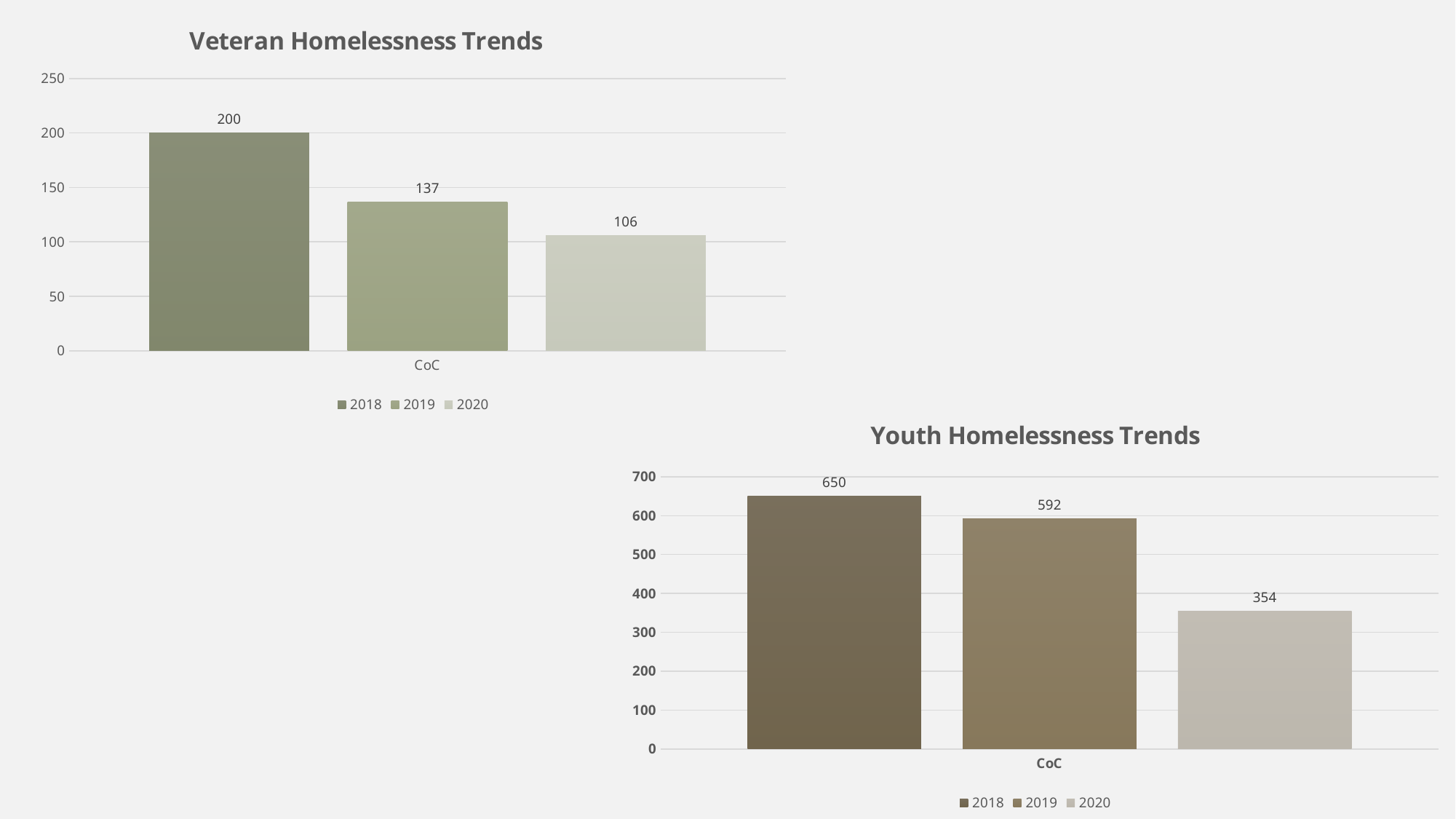
In the Veteran Homelessness Trends chart, do the values rise or fall from 2018 to 2020? Fall In the Youth Homelessness Trends chart, which is larger, the value for 2018 or the value for 2019? 2018 In the Youth Homelessness Trends chart, what is the value for 2019? 592 In the Youth Homelessness Trends chart, what is the difference between the 2019 and 2020 values? 238 In the Youth Homelessness Trends chart, what is the value for 2020? 354 In the Veteran Homelessness Trends chart, what is the value for 2018? 200 In the Veteran Homelessness Trends chart, which year has the highest value? 2018 In the Veteran Homelessness Trends chart, what is the value for 2020? 106 In the Youth Homelessness Trends chart, which year has the lowest value? 2020 How many series does the legend of the Veteran Homelessness Trends chart list? 3 What kind of chart is the Youth Homelessness Trends chart? Bar chart In the Veteran Homelessness Trends chart, what is the difference between the 2018 and 2019 values? 63